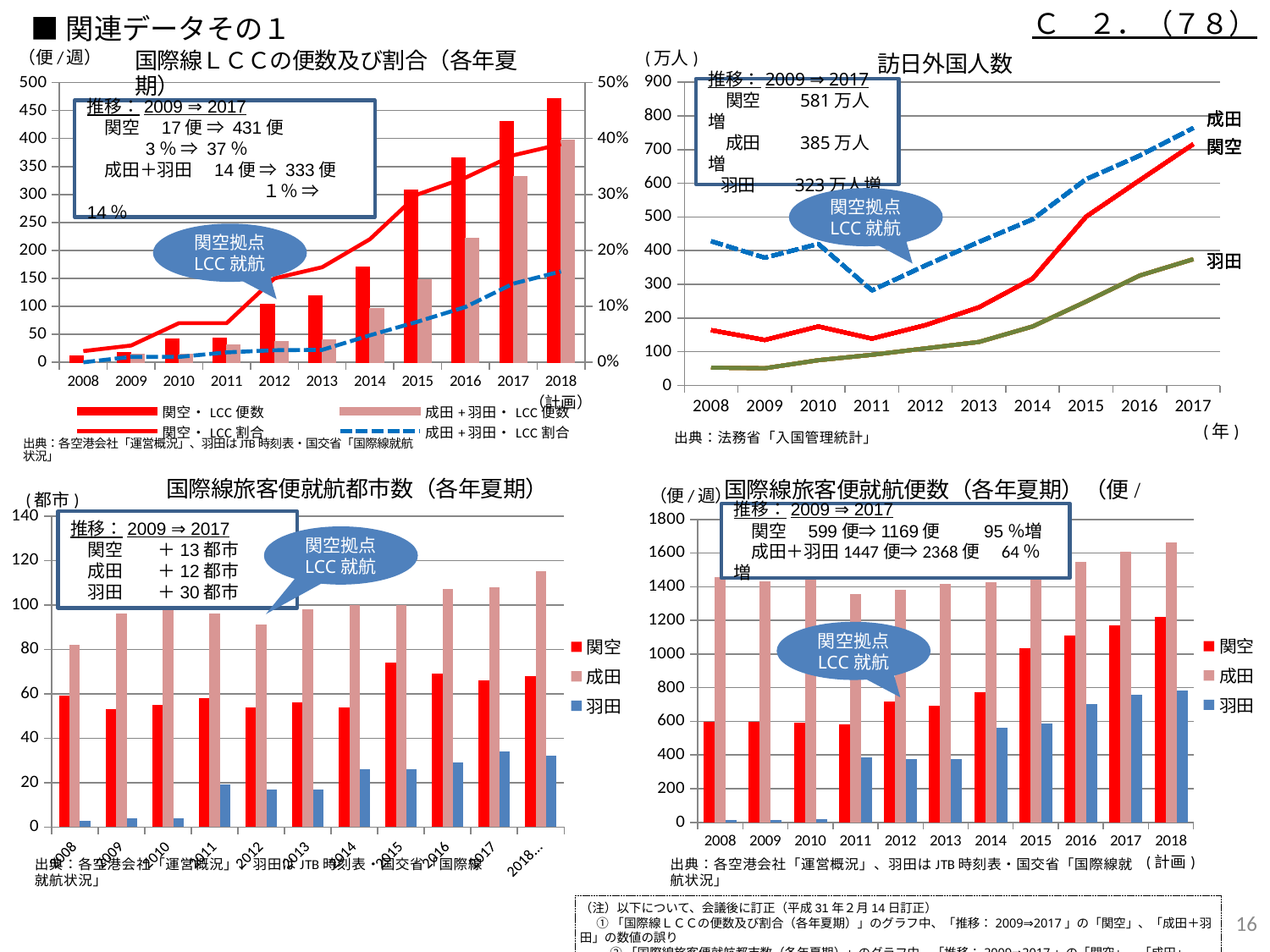
How many series does the legend of the 国際線LCCの便数及び割合 chart list? 4 In the 訪日外国人数 chart, which airport has the highest value in 2017? 成田 In the 国際線LCCの便数及び割合 chart, which bar is taller in 2018, 関空・LCC便数 or 成田+羽田・LCC便数? 関空・LCC便数 In the 訪日外国人数 chart, does the 羽田 line rise or fall from 2008 to 2017? rise In the 国際線旅客便就航都市数 chart, which airport has the highest bar in 2018? 成田 In the 訪日外国人数 chart, which airport has the lowest value in 2017? 羽田 What kind of chart is the 訪日外国人数 chart? line chart In the 国際線旅客便就航便数 chart, which airport has the lowest bar in 2018? 羽田 In the 国際線旅客便就航都市数 chart, is the value for 羽田 in 2008 greater or less than 20? less In the 訪日外国人数 chart, is the value for 成田 in 2017 greater or less than 700? greater In the 国際線旅客便就航便数 chart, is the value for 関空 in 2018 greater or less than 1000? greater